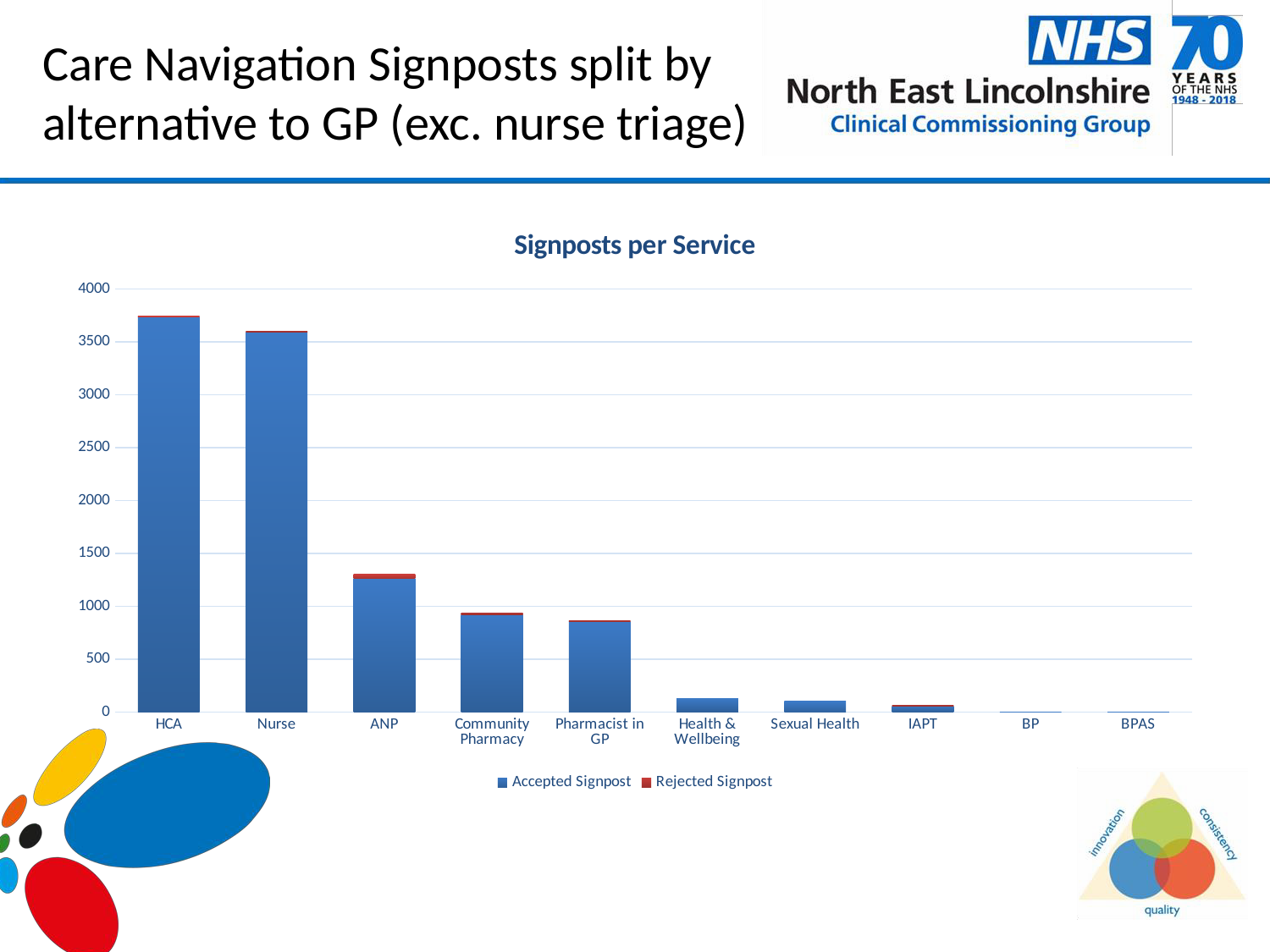
Which series is shown in red in the chart? Rejected Signpost What type of chart is shown on the slide? Bar chart Is the total value for ANP greater or less than 1000? greater Which service has the highest total number of signposts? HCA Which has a larger total, ANP or Pharmacist in GP? ANP Is the total value for HCA greater or less than 3500? greater How many series does the chart's legend list? 2 Is the total value for Health & Wellbeing greater or less than 500? less How many services (categories) are shown on the x axis of the chart? 10 Do the bar totals rise or fall moving from left to right along the x axis? Fall What is the title of the chart? Signposts per Service